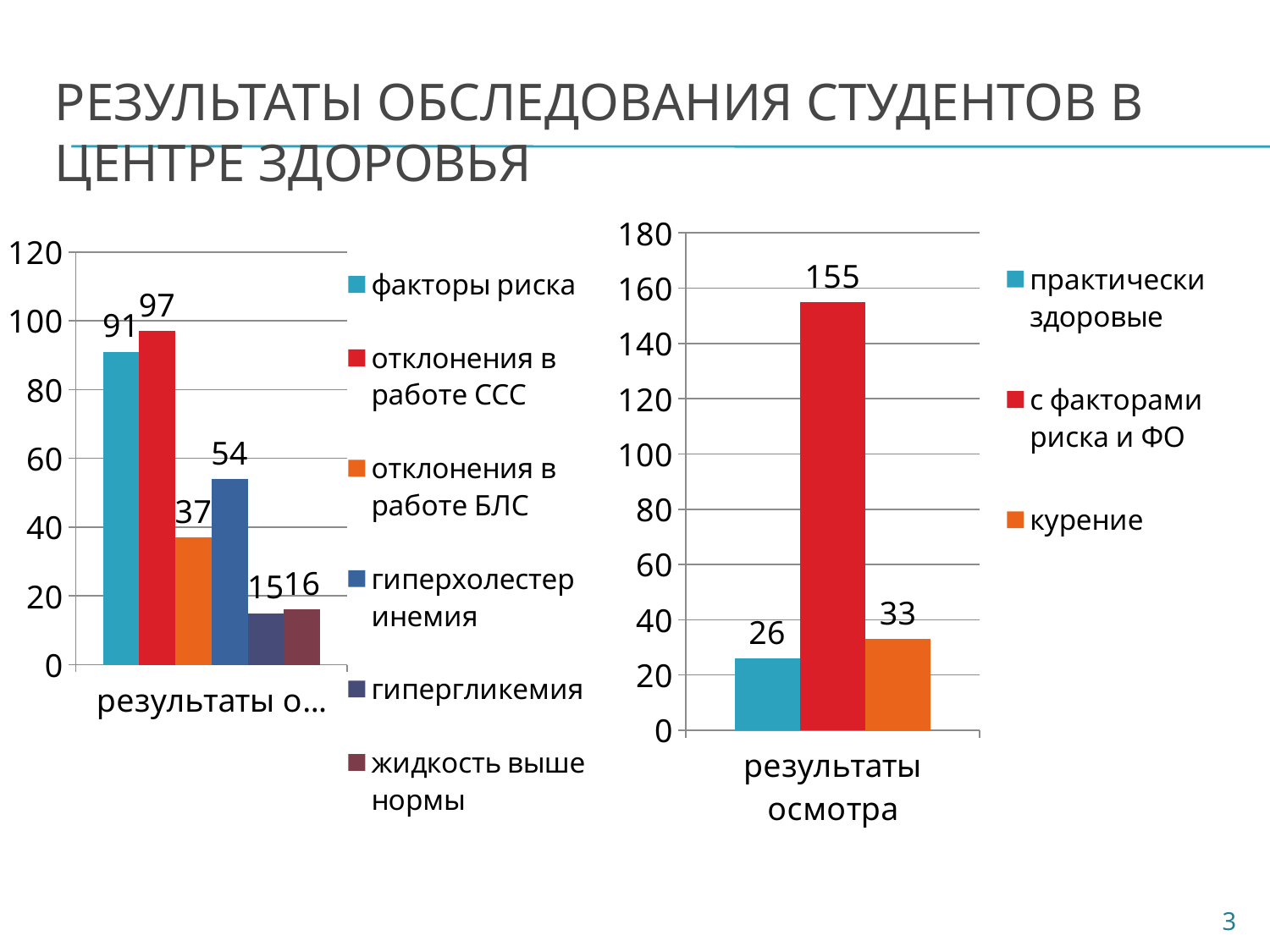
On the left chart, which is larger: гиперхолестеринемия or отклонения в работе БЛС? гиперхолестеринемия On the left chart, what is the difference between отклонения в работе ССС and отклонения в работе БЛС? 60 What kind of chart is the right chart? bar chart On the left chart, which series has the highest value? отклонения в работе ССС On the right chart, what is the value for с факторами риска и ФО? 155 On the right chart, what is the value for курение? 33 On the left chart, which series has the lowest value? гипергликемия On the left chart, what is the value for гиперхолестеринемия? 54 On the right chart, which series has the lowest value? практически здоровые On the left chart, what is the value for факторы риска? 91 On the left chart, how many series does the legend list? 6 On the right chart, what is the difference between с факторами риска и ФО and практически здоровые? 129